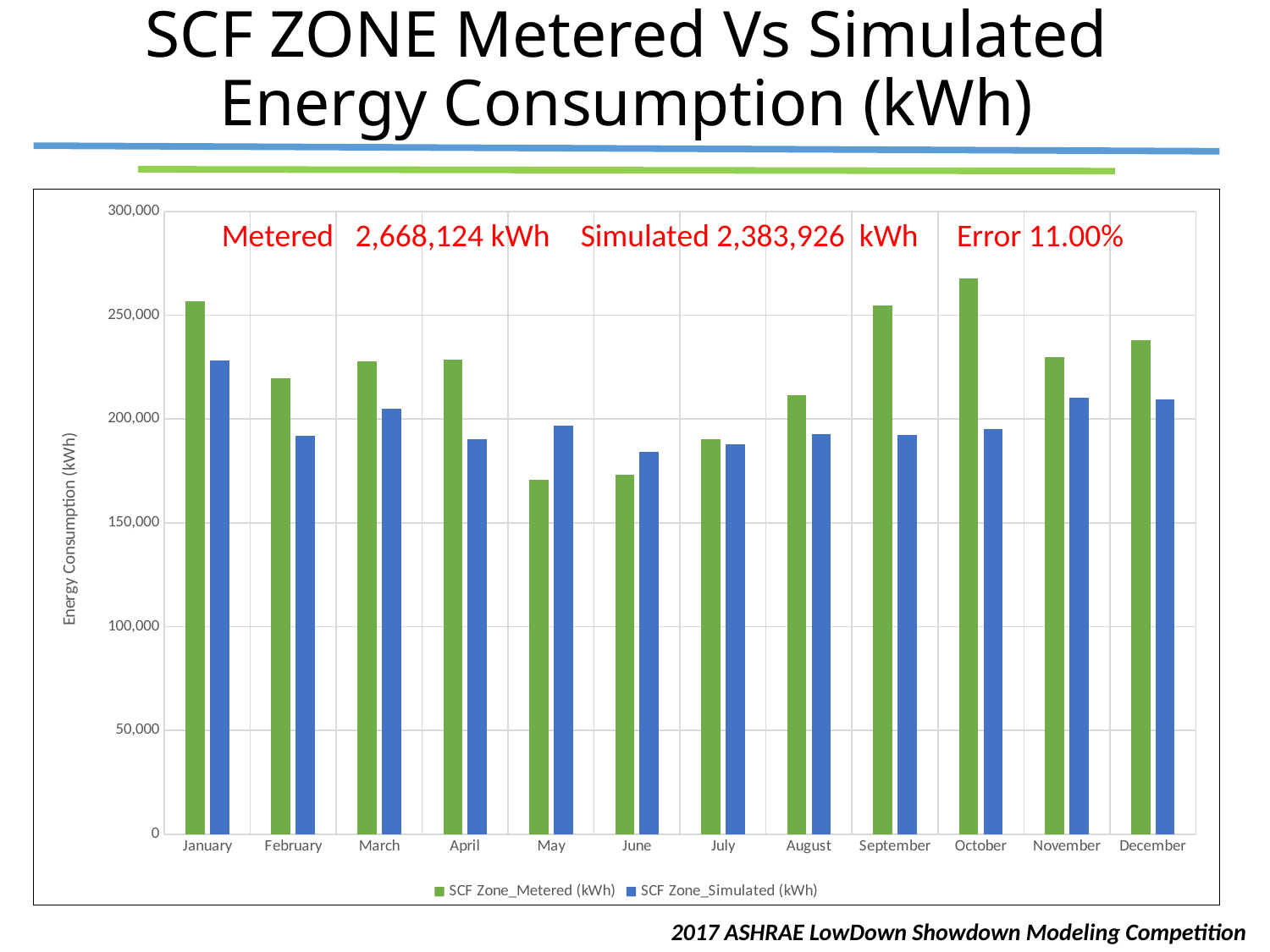
What kind of chart is shown on the slide? Bar chart Which month has the highest SCF Zone_Metered (kWh) value? October Is the SCF Zone_Metered (kWh) value for May greater or less than 200,000? less How many months (categories) are shown on the x axis? 12 How many series does the legend list? 2 Is the SCF Zone_Simulated (kWh) value for February greater or less than 200,000? less What error percentage is stated in the annotation on the chart? 11.00% Which month has the highest SCF Zone_Simulated (kWh) value? January Is the SCF Zone_Metered (kWh) value for January greater or less than 250,000? greater What total Metered energy consumption is stated in the annotation on the chart? 2,668,124 kWh In January, which is larger: the SCF Zone_Metered (kWh) value or the SCF Zone_Simulated (kWh) value? SCF Zone_Metered (kWh) In May, which is larger: the SCF Zone_Metered (kWh) value or the SCF Zone_Simulated (kWh) value? SCF Zone_Simulated (kWh)